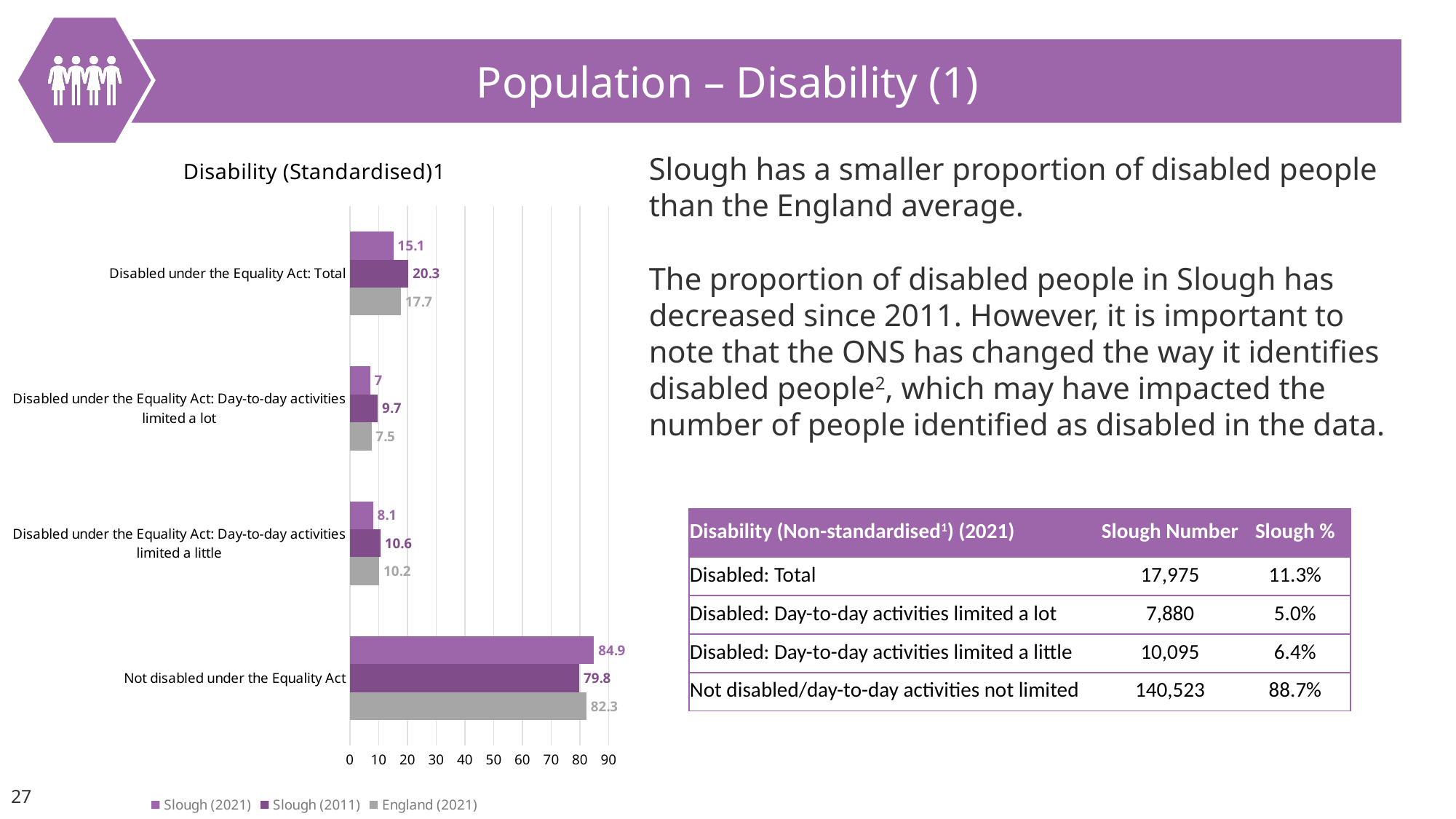
What is the Slough (2011) value for 'Not disabled under the Equality Act'? 79.8 Which category has the lowest England (2021) value? Disabled under the Equality Act: Day-to-day activities limited a lot What kind of chart is shown on the slide? Bar chart For 'Not disabled under the Equality Act', which is larger: Slough (2021) or England (2021)? Slough (2021) How many categories are shown on the chart? 4 How many series does the legend list? 3 What is the England (2021) value for 'Disabled under the Equality Act: Day-to-day activities limited a lot'? 7.5 Which category has the highest Slough (2021) value? Not disabled under the Equality Act What is the Slough (2021) value for 'Disabled under the Equality Act: Total'? 15.1 What is the Slough (2011) value for 'Disabled under the Equality Act: Day-to-day activities limited a little'? 10.6 What is the difference between the Slough (2011) and Slough (2021) values for 'Disabled under the Equality Act: Total'? 5.2 Is the Slough (2011) value for 'Not disabled under the Equality Act' greater or less than 70? greater